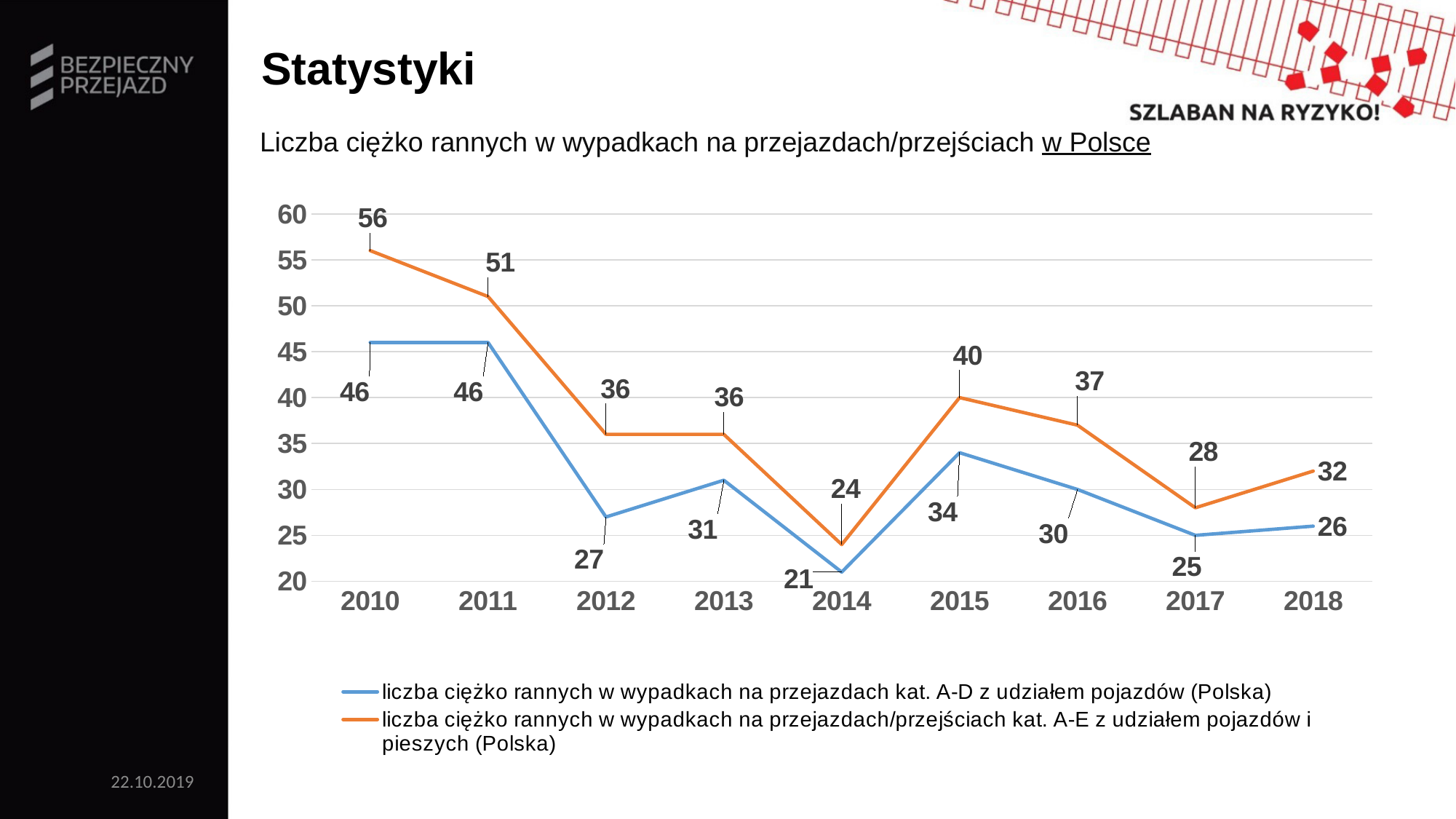
How many years are shown on the x axis? 9 In which year is the blue series (kat. A-D) at its lowest? 2014 Does the orange series rise or fall from 2010 to 2014? fall What kind of chart is shown on the slide? line chart What is the value of the blue series (kat. A-D z udziałem pojazdów) in 2018? 26 What is the value of the orange series (kat. A-E z udziałem pojazdów i pieszych) in 2015? 40 In which year is the orange series (kat. A-E) at its highest? 2010 What is the value of the orange series (kat. A-E z udziałem pojazdów i pieszych) in 2010? 56 How many series does the legend list? 2 What is the value of the blue series (kat. A-D z udziałem pojazdów) in 2014? 21 Which is larger: the blue series value in 2013 or the blue series value in 2016? 2013 What is the difference between the orange and blue series values in 2012? 9